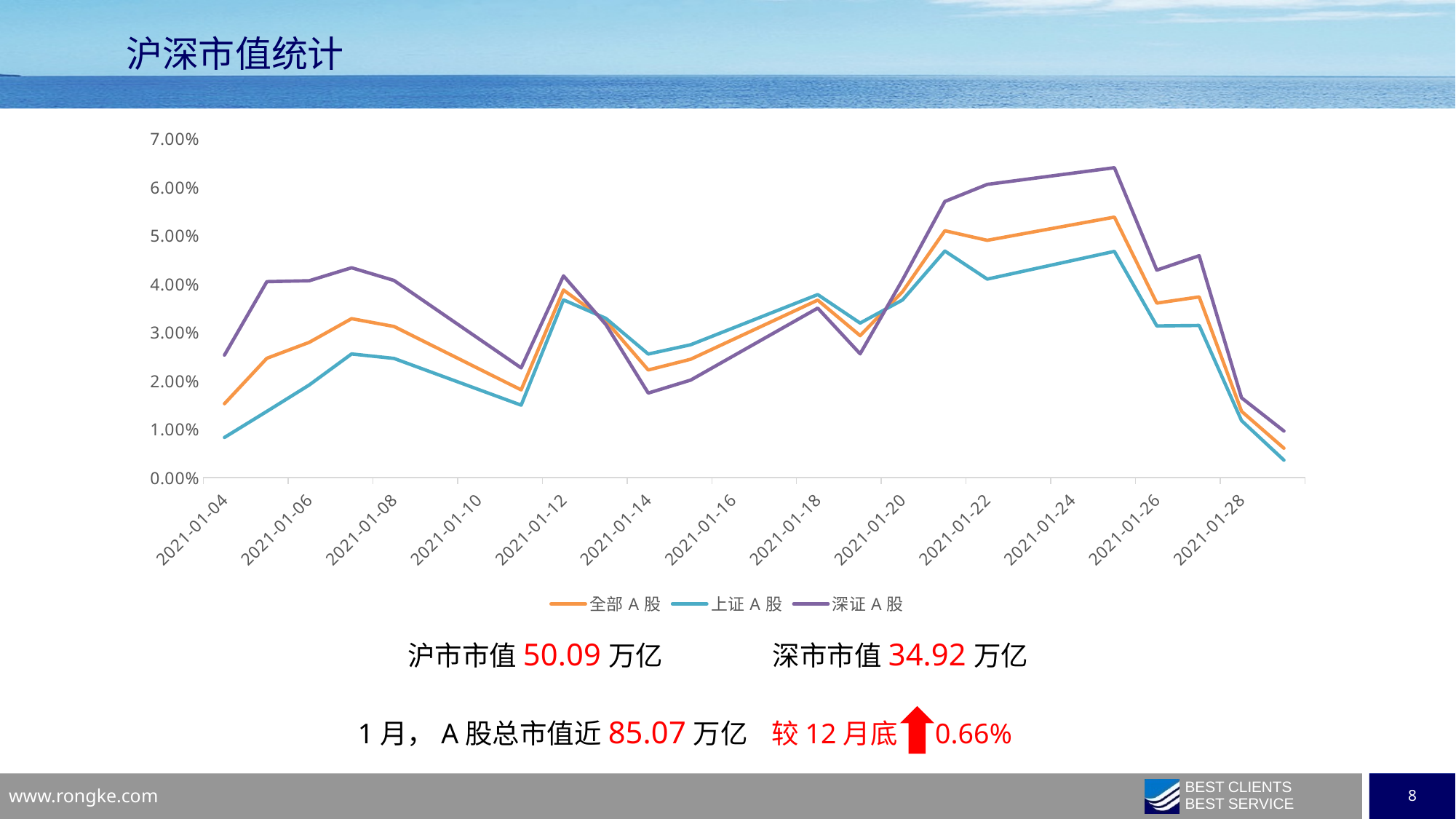
How many series does the chart legend list? 3 Is the value for 上证 A 股 at 2021-01-04 greater or less than 1.00%? less Which series has the lowest value at 2021-01-04? 上证 A 股 Is the value for 深证 A 股 at 2021-01-04 greater or less than 2.00%? greater Which series is drawn in purple according to the legend? 深证 A 股 What is the title of the slide containing the chart? 沪深市值统计 Is the value for 深证 A 股 at 2021-01-14 greater or less than 2.00%? less Do the three lines rise or fall from 2021-01-26 to the end of the chart? fall What kind of chart is shown on the slide? line chart Which series reaches the highest value anywhere on the chart? 深证 A 股 At 2021-01-14, which is larger: 上证 A 股 or 深证 A 股? 上证 A 股